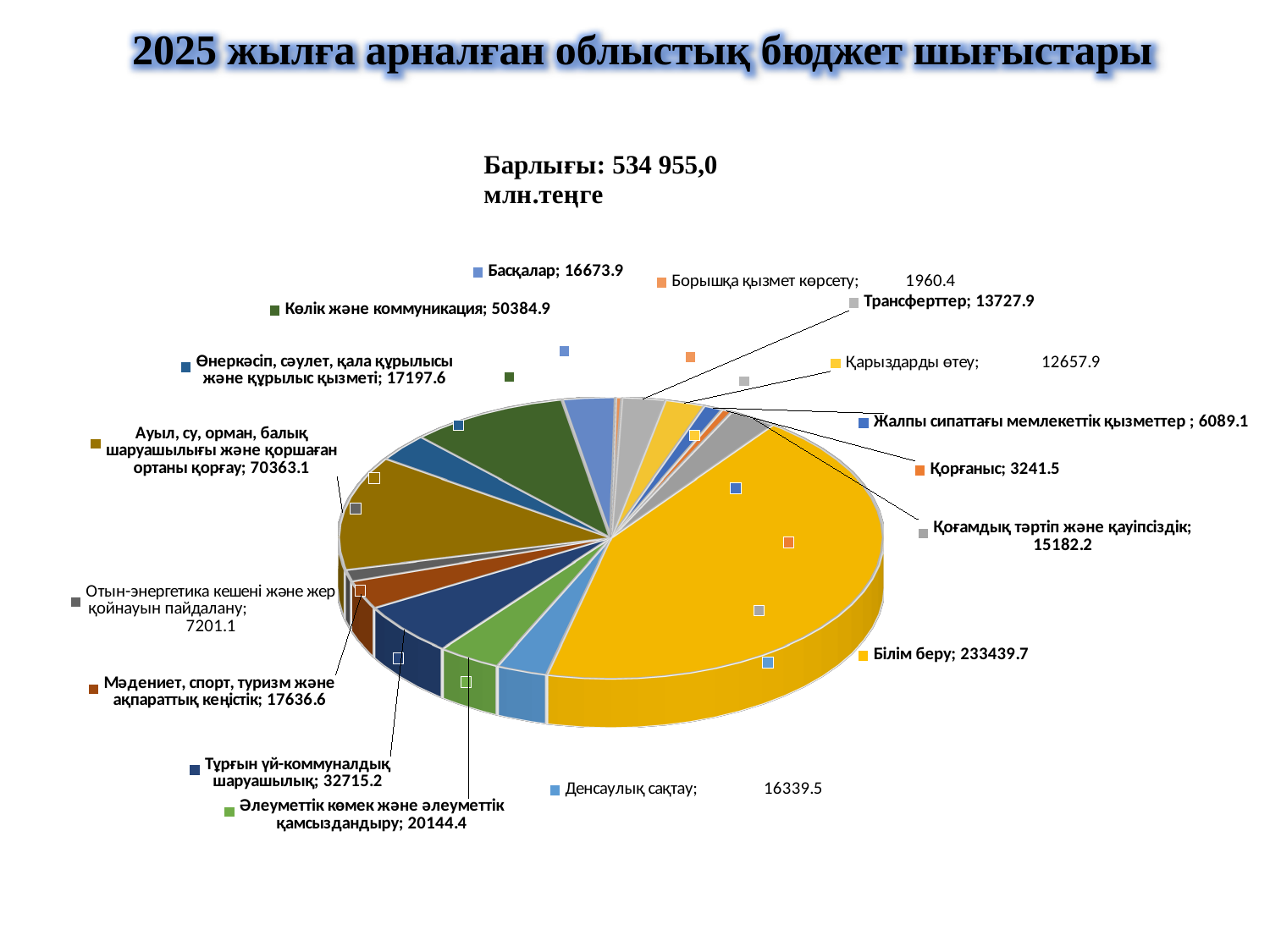
How many categories does the pie chart show? 16 What is the value for Тұрғын үй-коммуналдық шаруашылық? 32715.2 What type of chart is shown on the slide? Pie chart What total is stated above the chart? 534 955,0 млн.теңге What is the value for Ауыл, су, орман, балық шаруашылығы және қоршаған ортаны қорғау? 70363.1 What is the difference between Білім беру and Ауыл, су, орман, балық шаруашылығы және қоршаған ортаны қорғау? 163076.6 What is the difference between Көлік және коммуникация and Тұрғын үй-коммуналдық шаруашылық? 17669.7 Which is larger, Трансферттер or Қарыздарды өтеу? Трансферттер What is the value for Білім беру? 233439.7 What is the value for Денсаулық сақтау? 16339.5 Which category has the largest value? Білім беру Which category has the smallest value? Борышқа қызмет көрсету